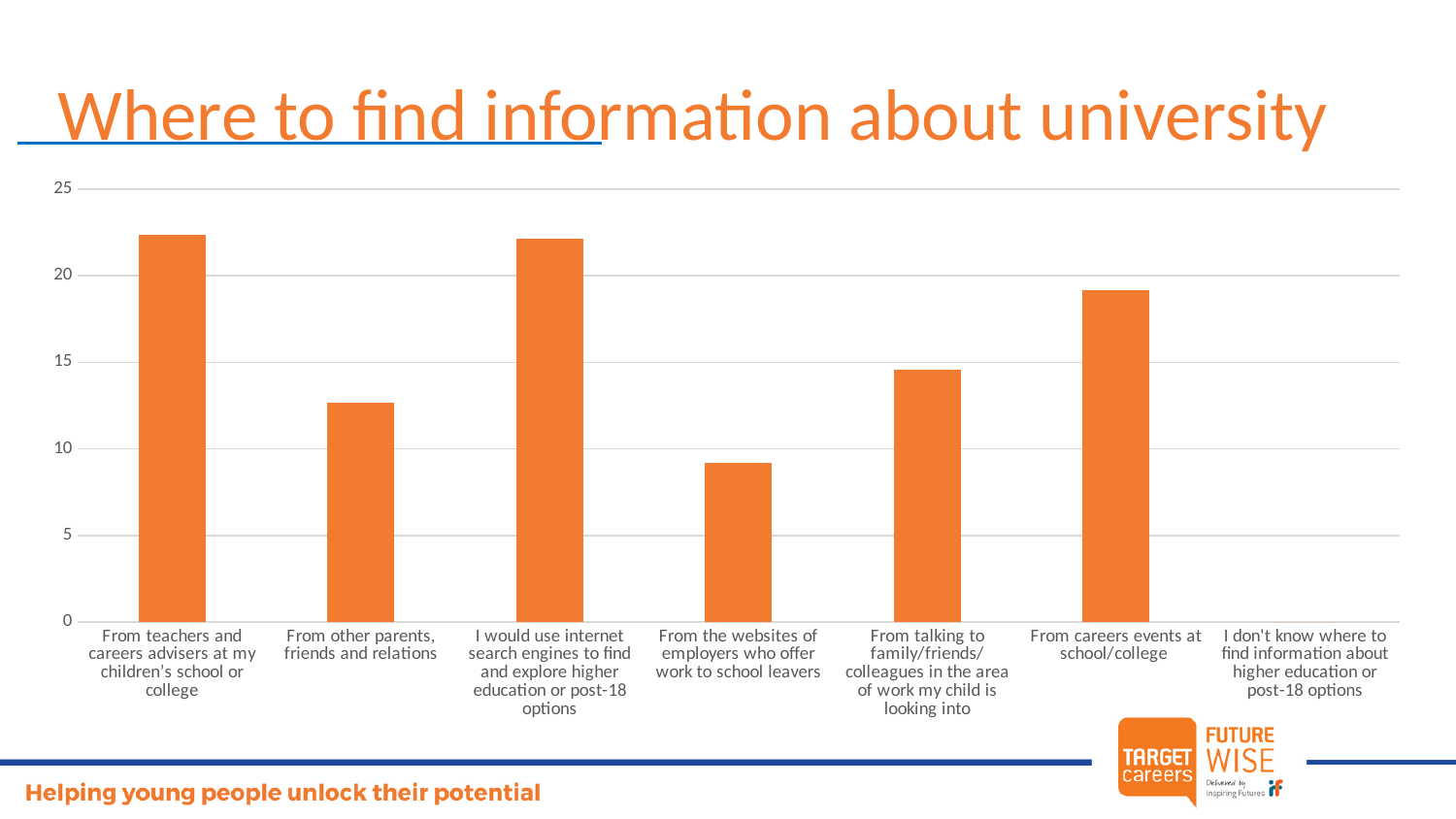
Is the value for 'From teachers and careers advisers at my children's school or college' greater or less than 20? greater What colour are the bars in the chart? orange Is the value for 'From careers events at school/college' greater or less than 20? less Is the value for 'I would use internet search engines to find and explore higher education or post-18 options' greater or less than 20? greater Which is larger: the value for 'From careers events at school/college' or the value for 'From the websites of employers who offer work to school leavers'? From careers events at school/college How many categories are labelled along the x axis? 7 What kind of chart is shown on the slide? bar chart Which is larger: the value for 'From other parents, friends and relations' or the value for 'From talking to family/friends/colleagues in the area of work my child is looking into'? From talking to family/friends/colleagues in the area of work my child is looking into What is the title of the chart? Where to find information about university